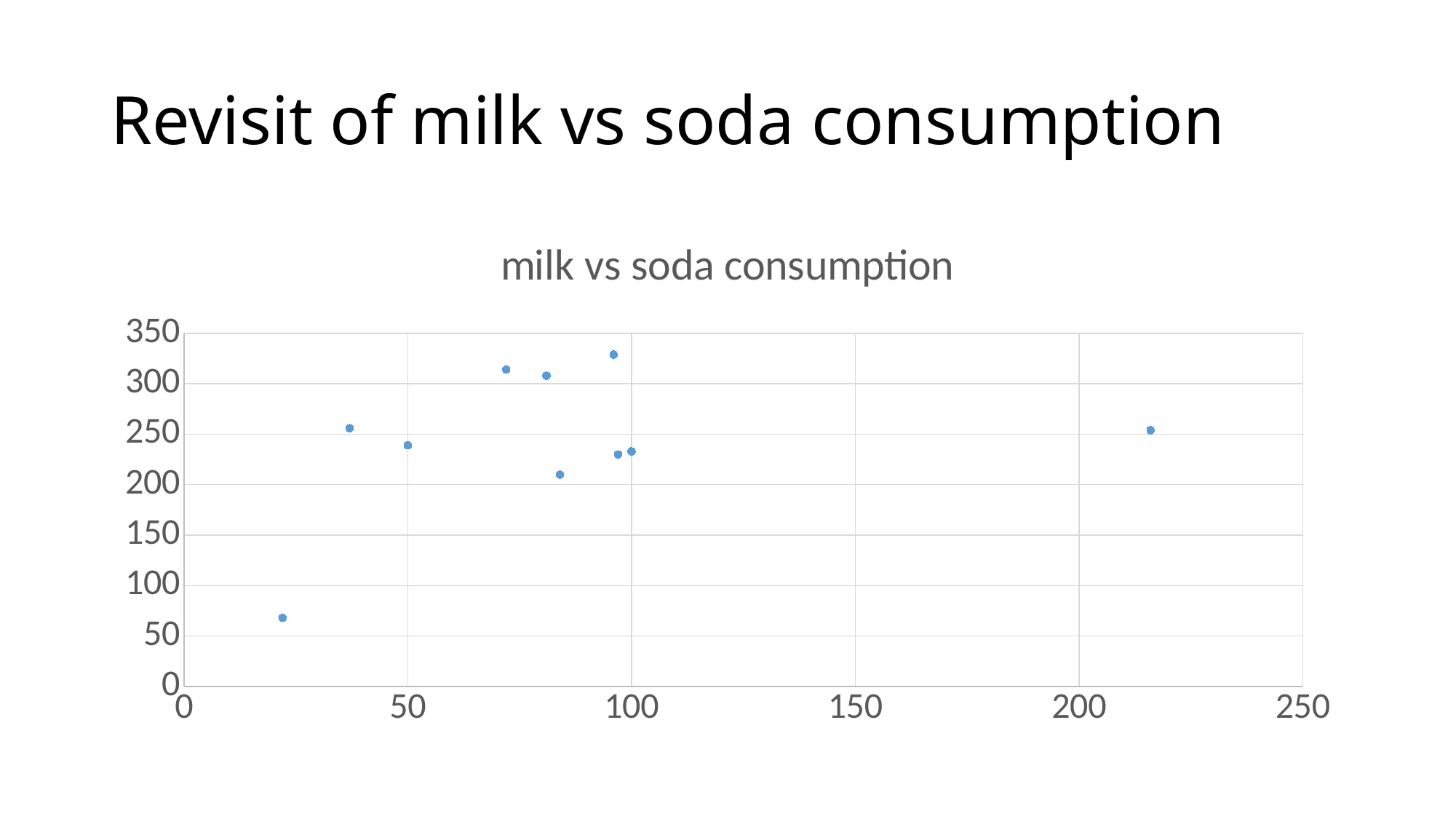
How many points in the chart have a y value above 300? 3 What is the maximum value shown on the y axis of the chart? 350 Is the y value of the lowest point in the chart greater or less than 100? less Is the x value of the rightmost point in the chart greater or less than 200? greater How many points in the chart have an x value greater than 150? 1 Is the x value of the leftmost point in the chart greater or less than 50? less How many data points are plotted in the chart? 10 What kind of chart is shown on the slide? scatter plot What is the title of the chart? milk vs soda consumption Which has the larger y value: the leftmost point or the rightmost point in the chart? the rightmost point